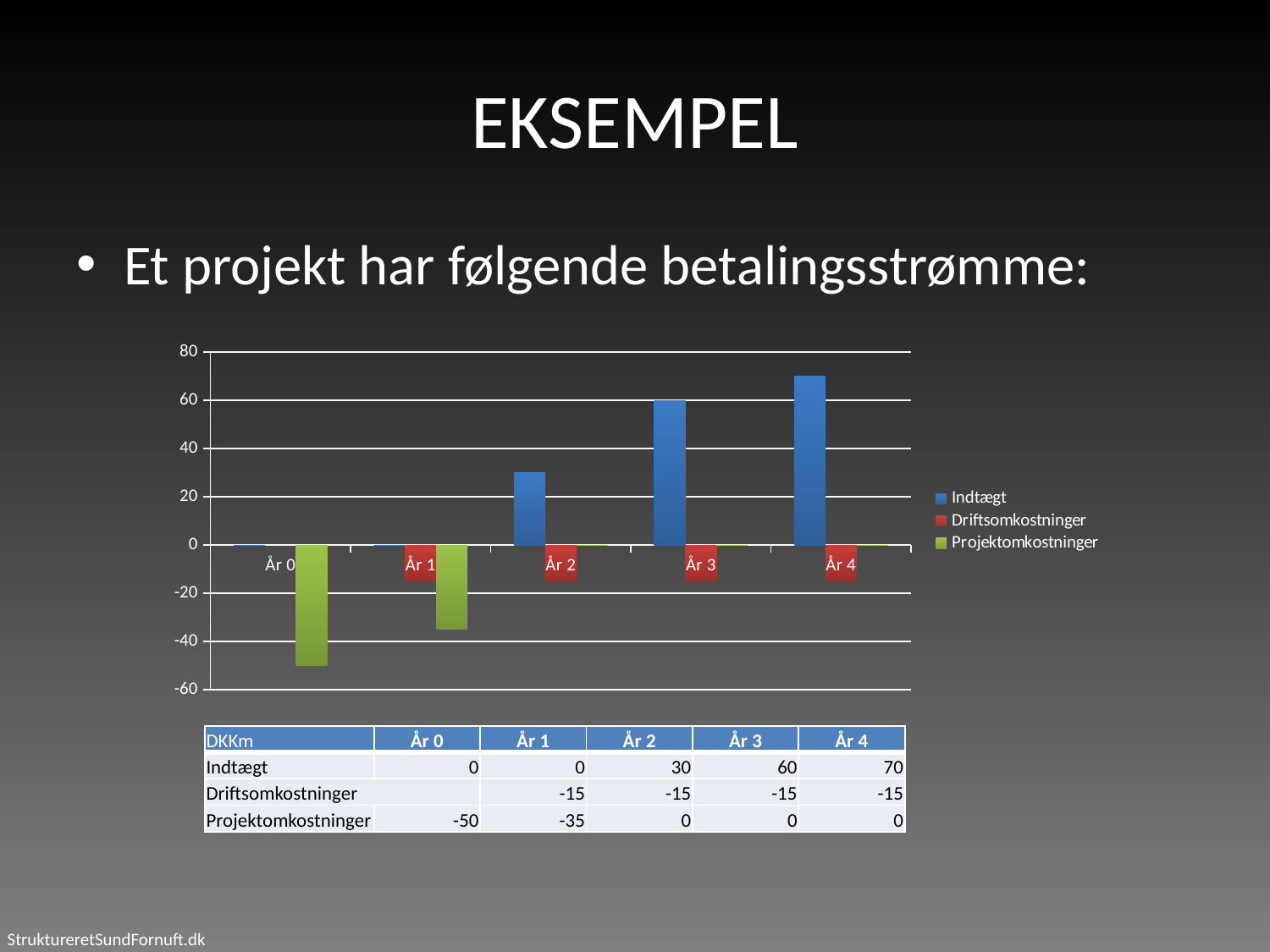
How many year categories are shown on the x axis? 5 What is the value of Indtægt in År 3? 60 What kind of chart is shown on the slide? bar chart Which series is shown in green in the legend? Projektomkostninger What is the difference between Indtægt in År 4 and Indtægt in År 2? 40 How many series does the legend list? 3 Which is larger, Indtægt in År 3 or Indtægt in År 2? Indtægt in År 3 Does Indtægt rise or fall from År 1 to År 4? rise In which year is Indtægt highest? År 4 In which year is Projektomkostninger lowest? År 0 What is the value of Driftsomkostninger in År 2? -15 What is the value of Projektomkostninger in År 0? -50